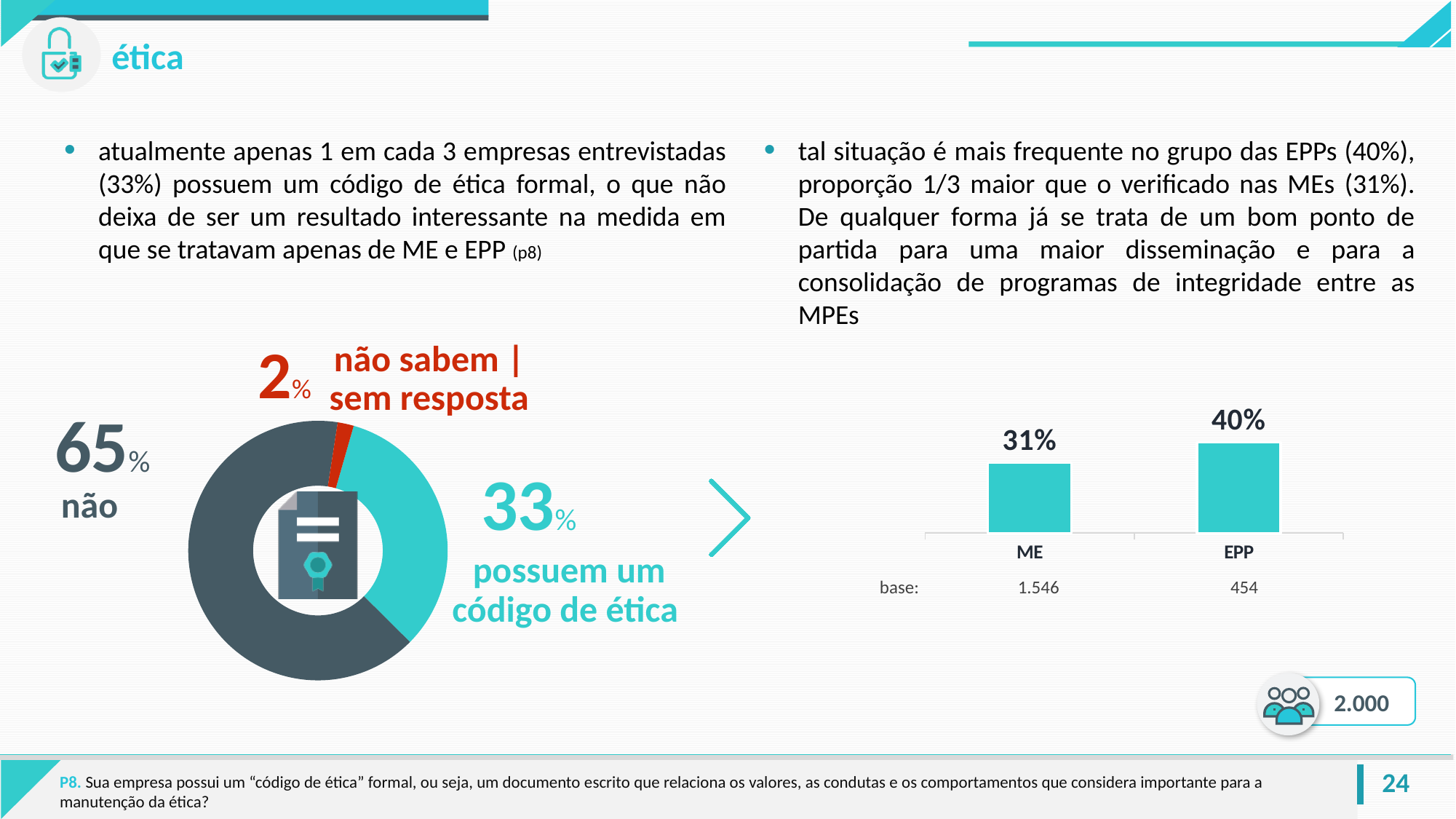
In the donut chart on the left, which category has the smallest share? não sabem | sem resposta In the donut chart on the left, what percentage of companies answered "não"? 65% In the donut chart on the left, what percentage is labelled "não sabem | sem resposta"? 2% In the donut chart on the left, which category has the largest share? não In the donut chart on the left, what is the difference in percentage points between "não" and "possuem um código de ética"? 32 In the bar chart on the right, what is the value for ME? 31% In the donut chart on the left, how many slices are shown? 3 In the bar chart on the right, which category has the higher value, ME or EPP? EPP In the bar chart on the right, what is the value for EPP? 40% In the bar chart on the right, what is the difference in percentage points between EPP and ME? 9 What kind of chart is shown on the right side of the slide? bar chart In the donut chart on the left, what percentage of companies "possuem um código de ética"? 33%